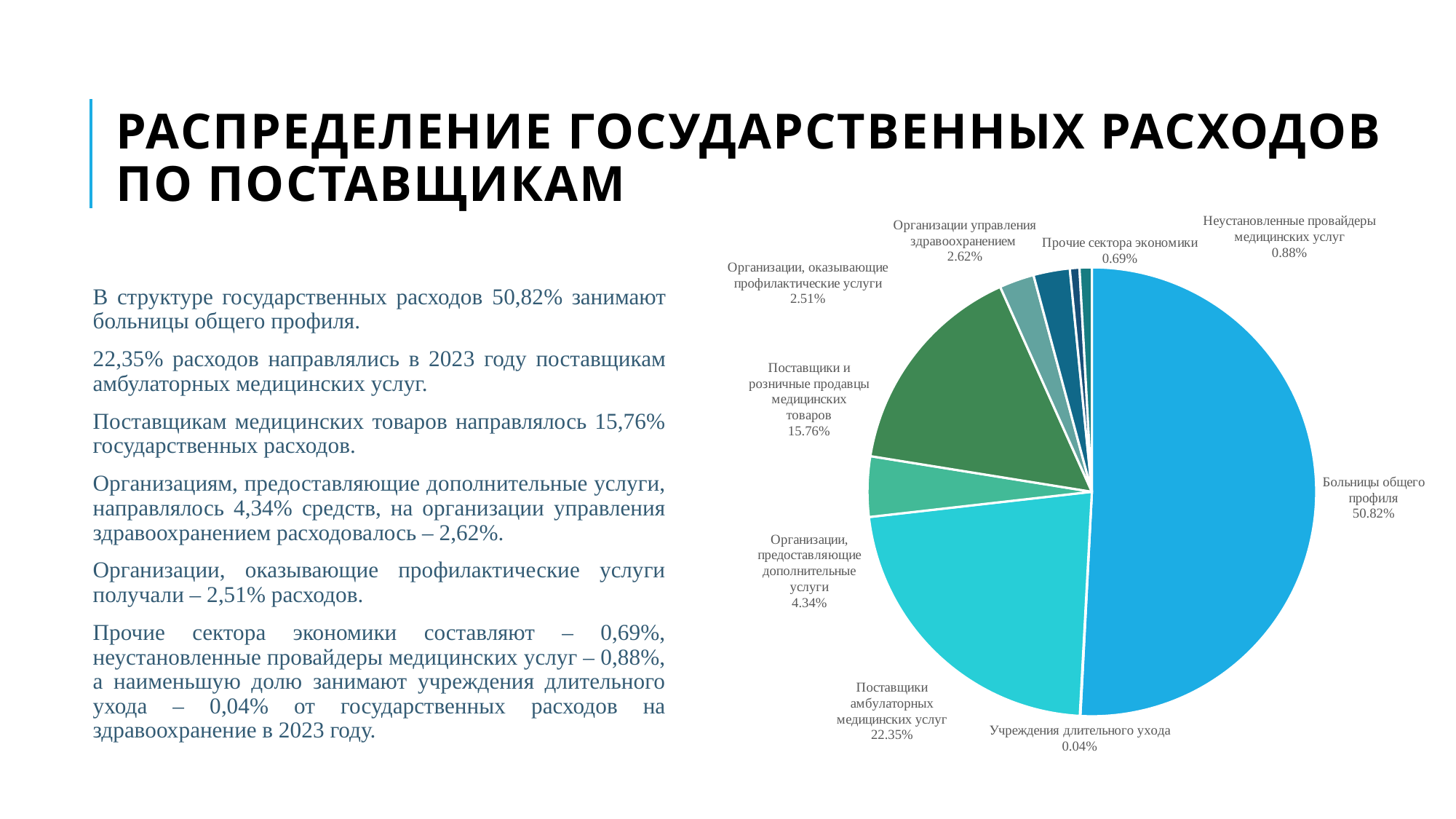
Which category has the smallest slice of the pie? Учреждения длительного ухода What is the value shown for "Учреждения длительного ухода"? 0.04% How many slices does the pie chart have? 9 Which category has the largest slice of the pie? Больницы общего профиля What is the value shown for "Поставщики амбулаторных медицинских услуг"? 22.35% What is the difference between the shares of "Поставщики амбулаторных медицинских услуг" and "Поставщики и розничные продавцы медицинских товаров"? 6.59% What share of the pie does "Больницы общего профиля" hold? 50.82% What is the value shown for "Поставщики и розничные продавцы медицинских товаров"? 15.76% What kind of chart is shown on the slide? Pie chart What is the title of the slide containing the pie chart? Распределение государственных расходов по поставщикам What is the value shown for "Организации управления здравоохранением"? 2.62% Which is larger: the share of "Неустановленные провайдеры медицинских услуг" or "Прочие сектора экономики"? Неустановленные провайдеры медицинских услуг